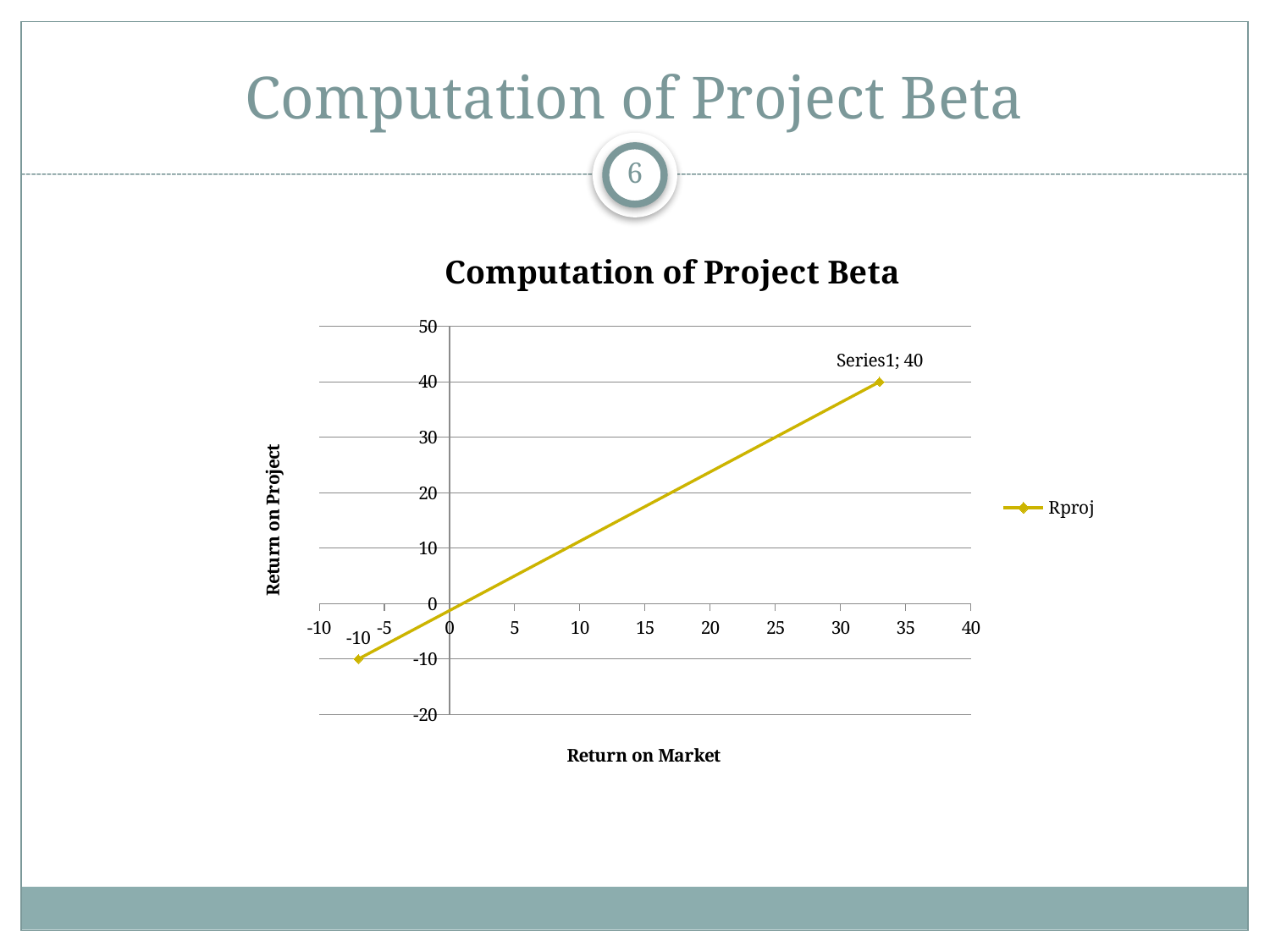
What is the highest Return on Project value labelled on the chart? 40 How many series does the legend list? 1 Is the Return on Market for the data point labelled 'Series1; 40' greater or less than 30? greater Does the Return on Project rise or fall as Return on Market increases? rise What kind of chart is shown on the slide? line chart Which data point has the larger Return on Project, the one at the left end of the line or the one at the right end? the right end What is the name of the series shown in the legend? Rproj What is the difference between the highest and lowest labelled Return on Project values? 50 Is the Return on Market for the data point labelled '-10' greater or less than -5? less How many data points are plotted on the line? 2 What is the title of the chart? Computation of Project Beta What is the lowest Return on Project value labelled on the chart? -10